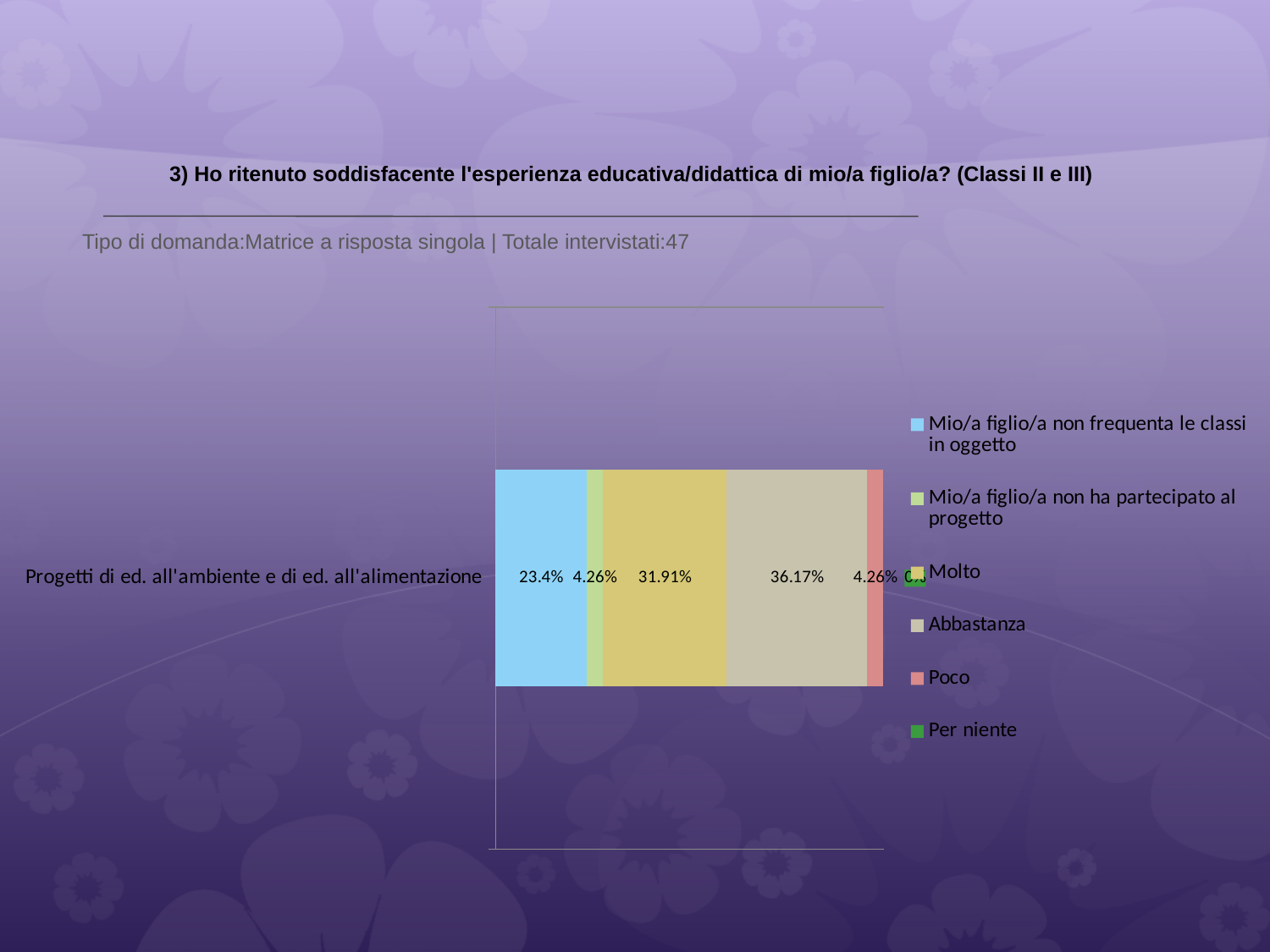
What is the total number of respondents (Totale intervistati) stated on the slide? 47 What percentage of respondents answered "Abbastanza"? 36.17% Which response has the largest share of the bar? Abbastanza What is the value for "Mio/a figlio/a non frequenta le classi in oggetto"? 23.4% What is the difference between the "Abbastanza" and "Molto" percentages? 4.26% What is the value for "Poco"? 4.26% What is the difference between "Mio/a figlio/a non frequenta le classi in oggetto" and "Mio/a figlio/a non ha partecipato al progetto"? 19.14% What kind of chart is shown on the slide? Stacked bar chart How many series does the legend list? 6 How many categories are plotted on the chart? 1 What percentage of respondents answered "Molto" for "Progetti di ed. all'ambiente e di ed. all'alimentazione"? 31.91% Which is larger, the share for "Molto" or for "Abbastanza"? Abbastanza